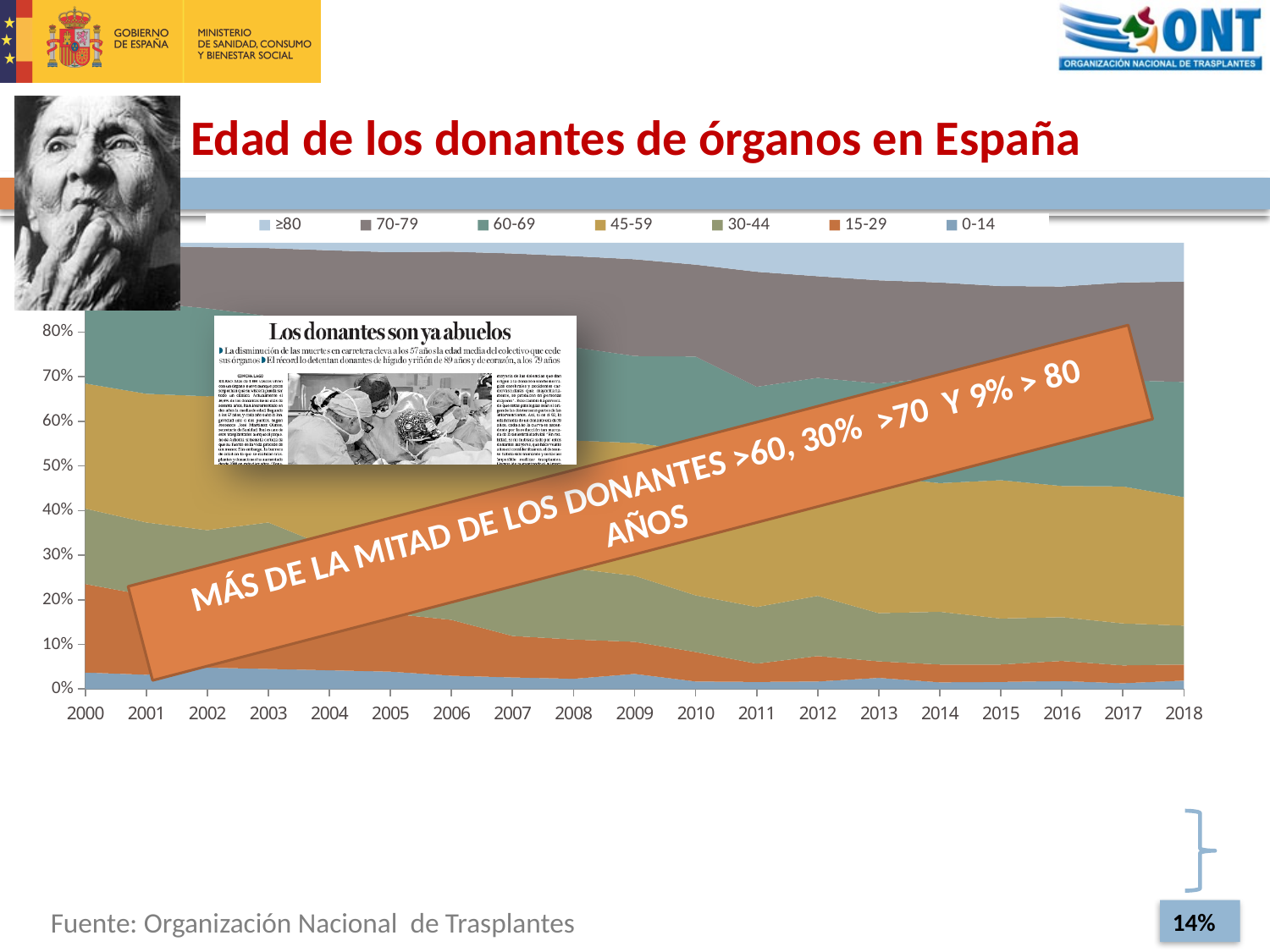
Does the share of donors aged 15-29 rise or fall from 2000 to 2018? Fall What is the last year shown on the x axis of the chart? 2018 How many years are shown along the x axis of the chart? 19 Does the share of donors aged ≥80 rise or fall from 2000 to 2018? Rise Does the share of donors aged 30-44 rise or fall from 2000 to 2018? Fall Which age group is listed first in the chart legend? ≥80 In 2018, is the combined share of donors aged 0-14 and 15-29 greater or less than 10%? less What is the first year shown on the x axis of the chart? 2000 In 2000, is the share of donors aged 0-14 greater or less than 10%? less What is the title of the chart on the slide? Edad de los donantes de órganos en España What kind of chart is shown on the slide? Stacked area chart How many age-group series does the chart legend list? 7